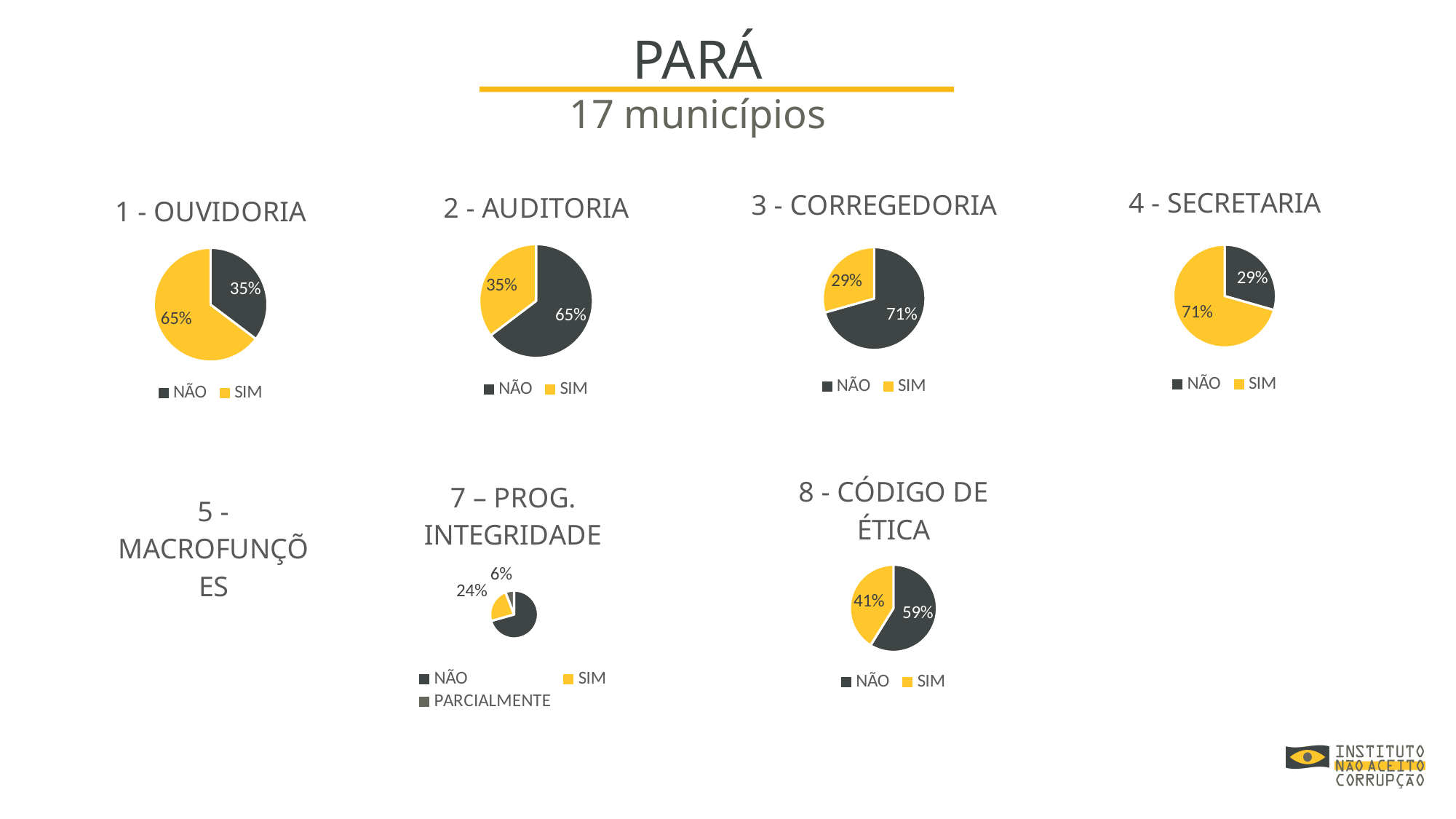
In the "1 - OUVIDORIA" pie chart, what share is NÃO? 35% In the "2 - AUDITORIA" pie chart, what share is NÃO? 65% In the "8 - CÓDIGO DE ÉTICA" pie chart, what share is NÃO? 59% What type of chart is used for "3 - CORREGEDORIA"? Pie chart In the "8 - CÓDIGO DE ÉTICA" pie chart, what is the difference between the NÃO and SIM shares? 18% In the "2 - AUDITORIA" pie chart, which colour represents SIM? Yellow In the "7 – PROG. INTEGRIDADE" pie chart, what share is PARCIALMENTE? 6% In the "7 – PROG. INTEGRIDADE" pie chart, what share is SIM? 24% In the "1 - OUVIDORIA" pie chart, what share is SIM? 65% In the "4 - SECRETARIA" pie chart, which slice is larger, NÃO or SIM? SIM How many entries does the legend of the "7 – PROG. INTEGRIDADE" chart list? 3 In the "3 - CORREGEDORIA" pie chart, what share is SIM? 29%